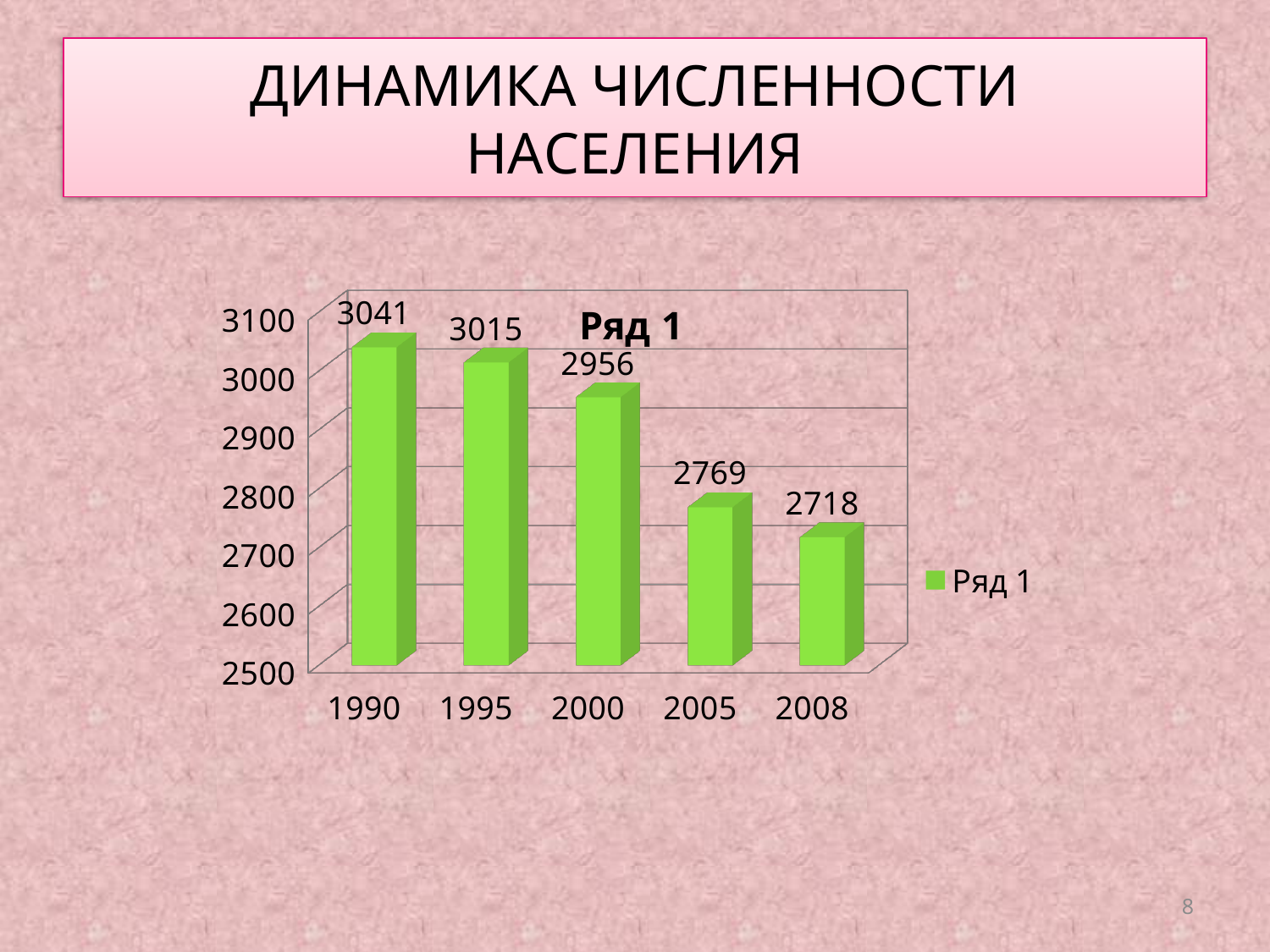
What is the value for 2008? 2718 What is the value for 1990? 3041 How many series does the legend list? 1 What kind of chart is shown? bar chart What is the value for 2005? 2769 Do the values rise or fall from 1990 to 2008? fall Which is larger, the value for 1995 or the value for 2000? 1995 What is the difference between the values for 1990 and 2008? 323 What is the difference between the values for 2000 and 2005? 187 How many years are shown on the x axis? 5 Which year has the highest value? 1990 Which year has the lowest value? 2008